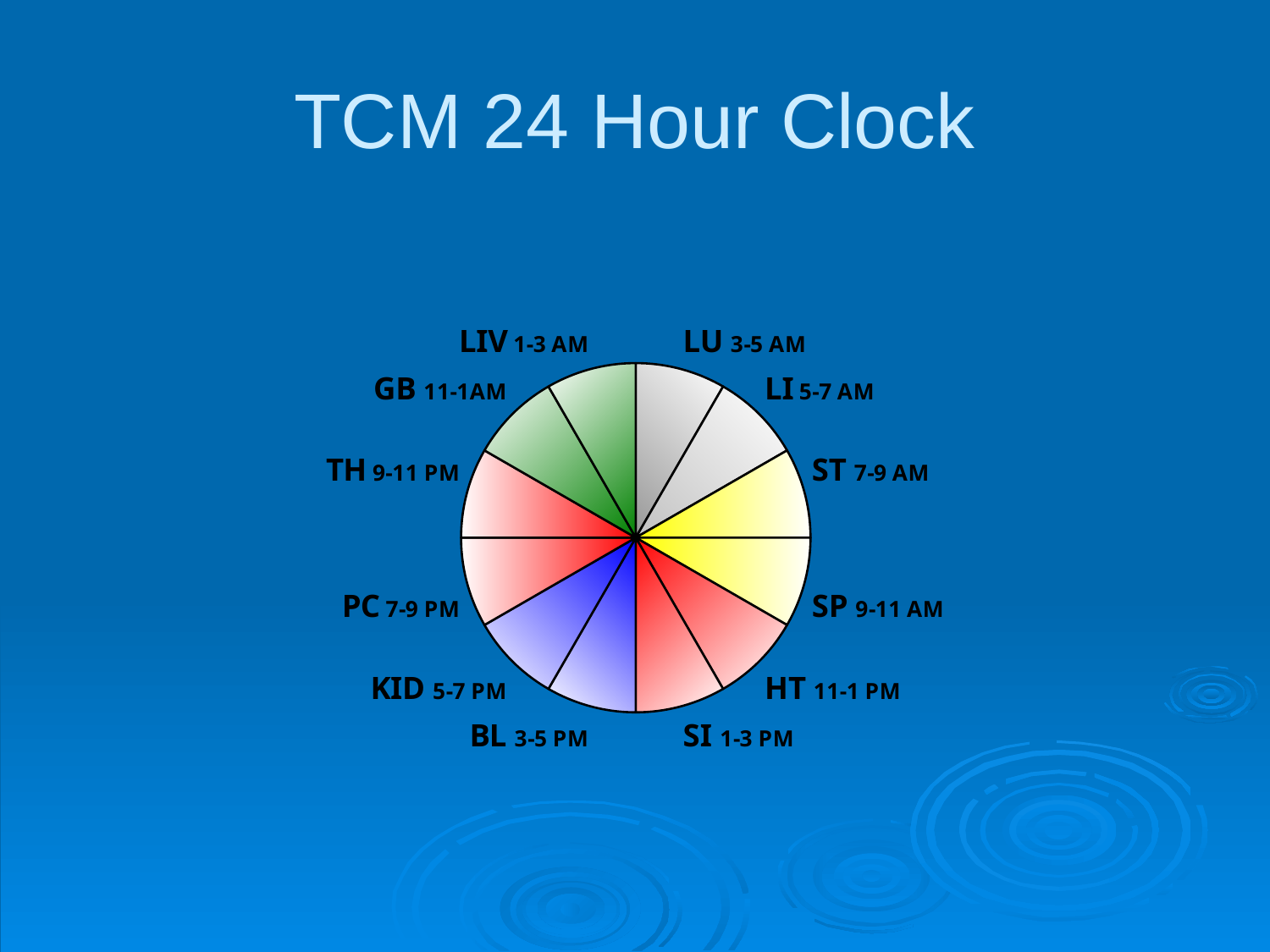
What colour are the ST and SP slices of the pie chart? yellow What time range is labelled for the HT slice? 11-1 PM What time range is labelled for the LU slice? 3-5 AM Which slice is labelled with the time range 7-9 PM? PC What is the title of the slide containing the pie chart? TCM 24 Hour Clock How many slices does the pie chart have? 12 What time range is labelled for the ST slice? 7-9 AM What time range is labelled for the GB slice? 11-1AM Which slice is labelled with the time range 1-3 PM? SI What time range is labelled for the KID slice? 5-7 PM What kind of chart is shown on the slide? pie chart Which slice is labelled with the time range 1-3 AM? LIV